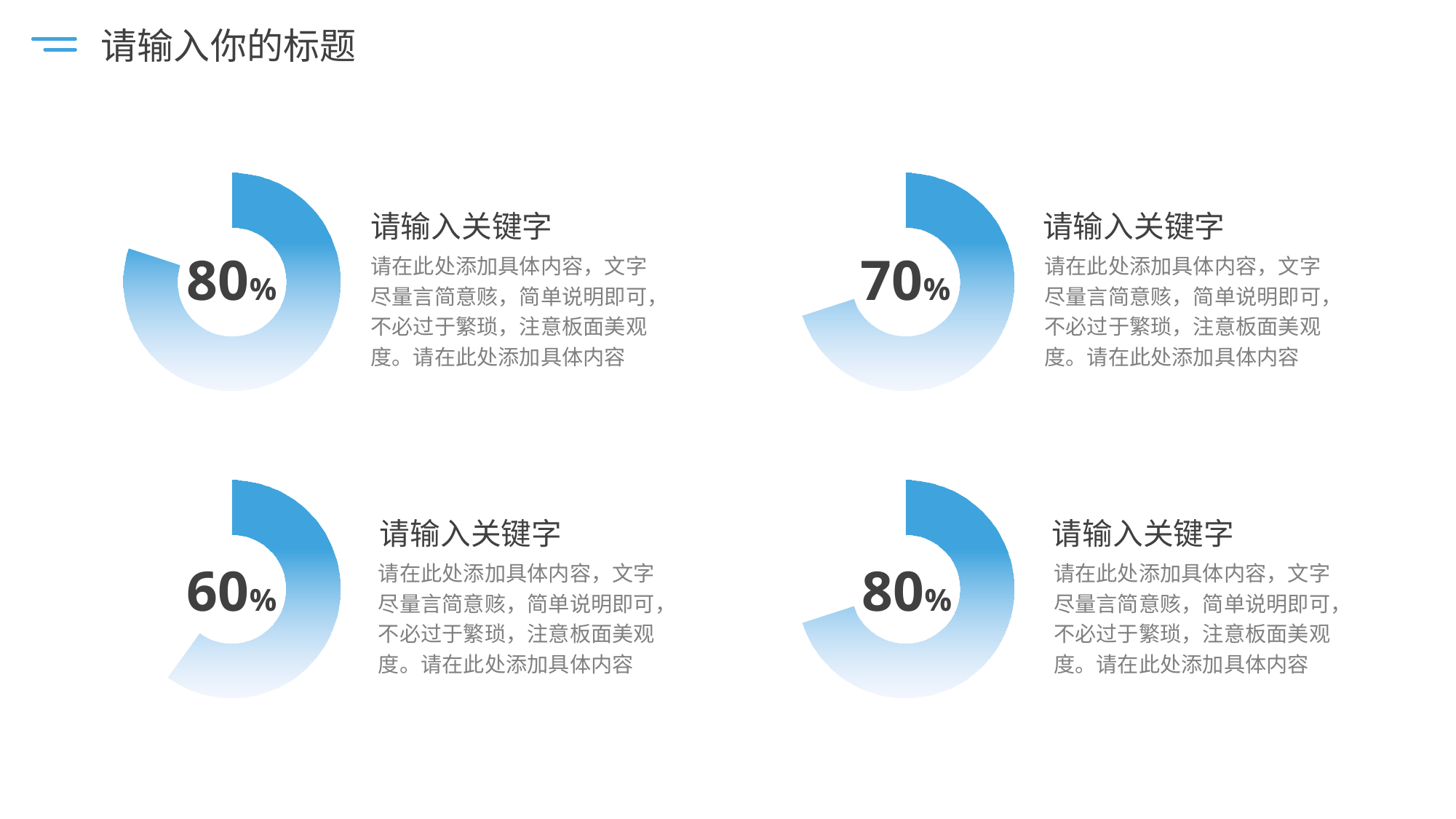
Which is larger, the percentage in the top-left donut chart or the top-right donut chart? Top-left (80%) What percentage is shown in the bottom-left donut chart? 60% What is the difference between the bottom-right donut chart's percentage and the top-right donut chart's percentage? 10% What percentage is shown in the bottom-right donut chart? 80% What colour are the filled portions of the donut charts? Blue What percentage is shown in the top-left donut chart? 80% What is the difference between the top-right donut chart's percentage and the bottom-left donut chart's percentage? 10% Which donut chart shows the lowest percentage? Bottom-left (60%) How many donut charts are on the slide? 4 What kind of chart is used for each of the four figures on the slide? Donut chart What percentage is shown in the top-right donut chart? 70% Is the percentage in the bottom-left donut chart greater or less than 70%? less